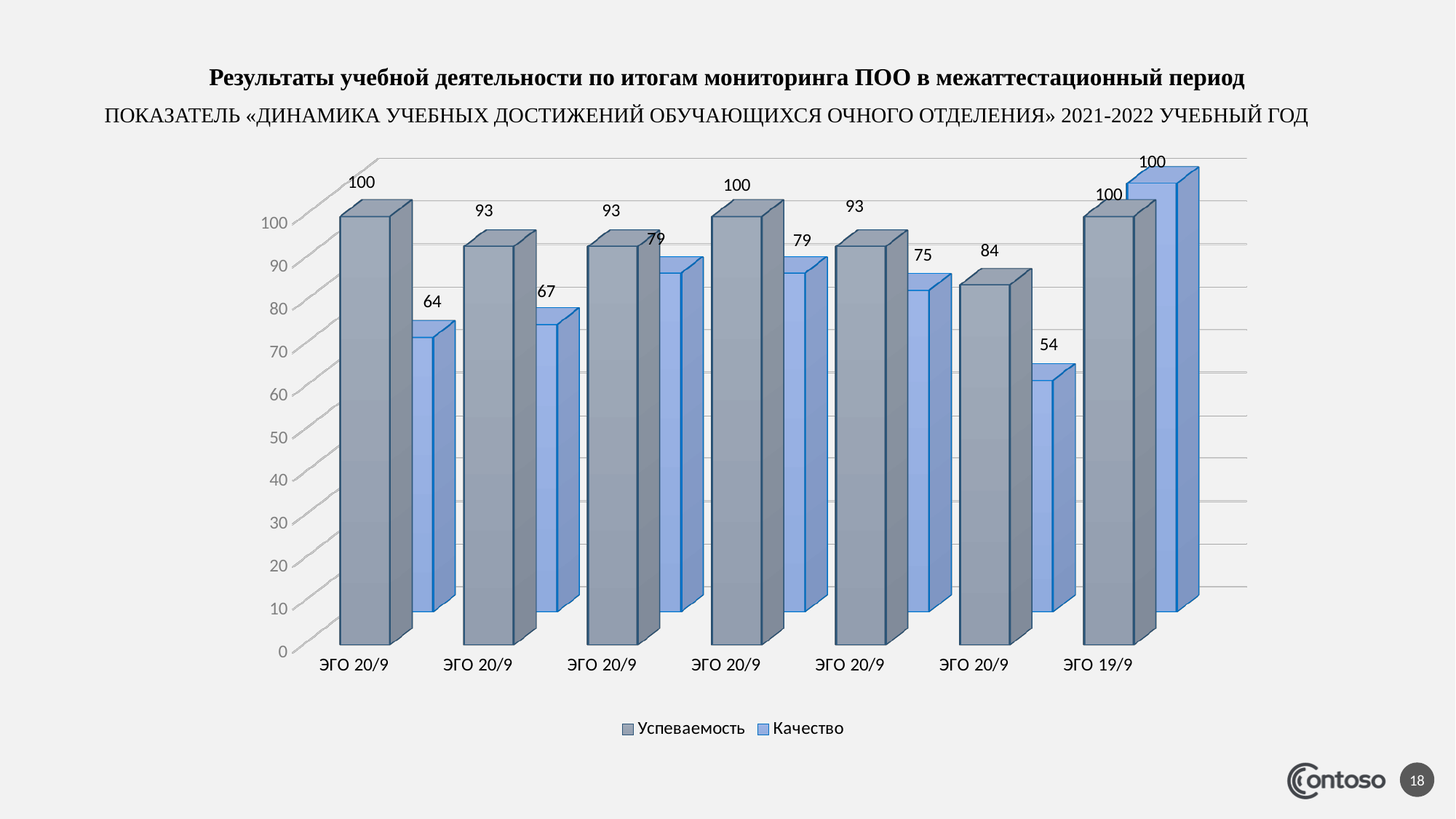
Which series is shown in blue in the legend? Качество Which category has the lowest Качество value? the sixth category (last ЭГО 20/9), 54 How many categories are shown on the x axis of the chart? 7 What is the Успеваемость value for the sixth category on the x axis (the last ЭГО 20/9)? 84 How many series does the legend list? 2 What is the Успеваемость value for the category ЭГО 19/9? 100 Which category has the lowest Успеваемость value? the sixth category (last ЭГО 20/9), 84 What is the Качество value for the first category on the x axis (leftmost ЭГО 20/9)? 64 What is the Качество value for the category ЭГО 19/9? 100 What is the difference between Успеваемость and Качество for the category ЭГО 19/9? 0 What type of chart is shown on the slide? bar chart What is the difference between Успеваемость (84) and Качество (54) for the sixth category on the x axis? 30